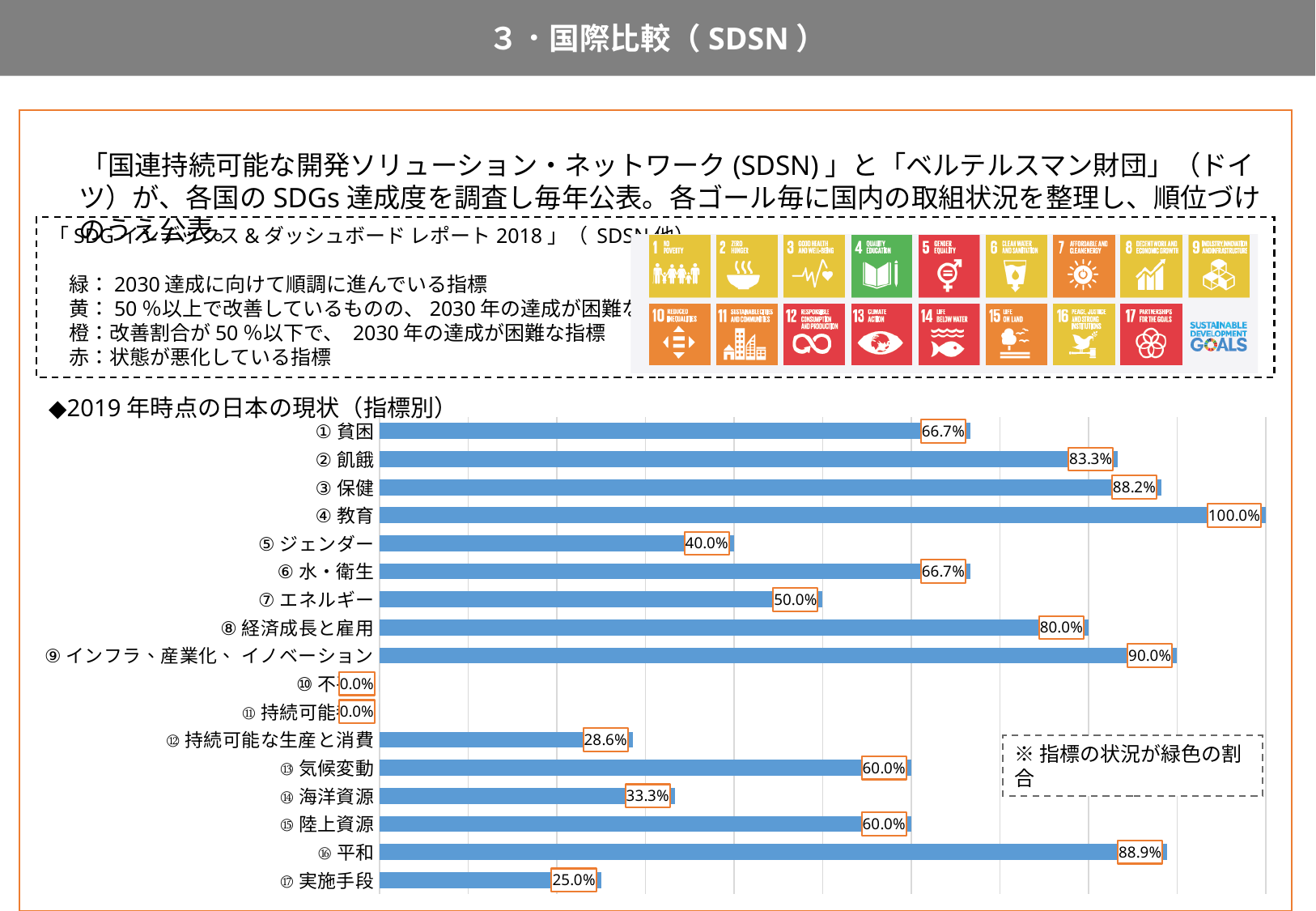
How many categories (indicators) are plotted in the chart? 17 Do ⑬ 気候変動 and ⑮ 陸上資源 have the same value? Yes, 60.0% What is the value for ⑯ 平和? 88.9% What is the value for ⑤ ジェンダー? 40.0% What is the value for ④ 教育? 100.0% What is the value for ⑫ 持続可能な生産と消費? 28.6% Which is larger, the value for ③ 保健 or the value for ⑨ インフラ、産業化、イノベーション? ⑨ インフラ、産業化、イノベーション What type of chart is shown on the slide? bar chart Among the indicators with a non-zero value, which has the lowest value? ⑰ 実施手段 Which indicator has the highest value? ④ 教育 What is the difference between the values for ② 飢餓 and ⑭ 海洋資源? 50.0% According to the note on the chart, what do the plotted values represent? 指標の状況が緑色の割合